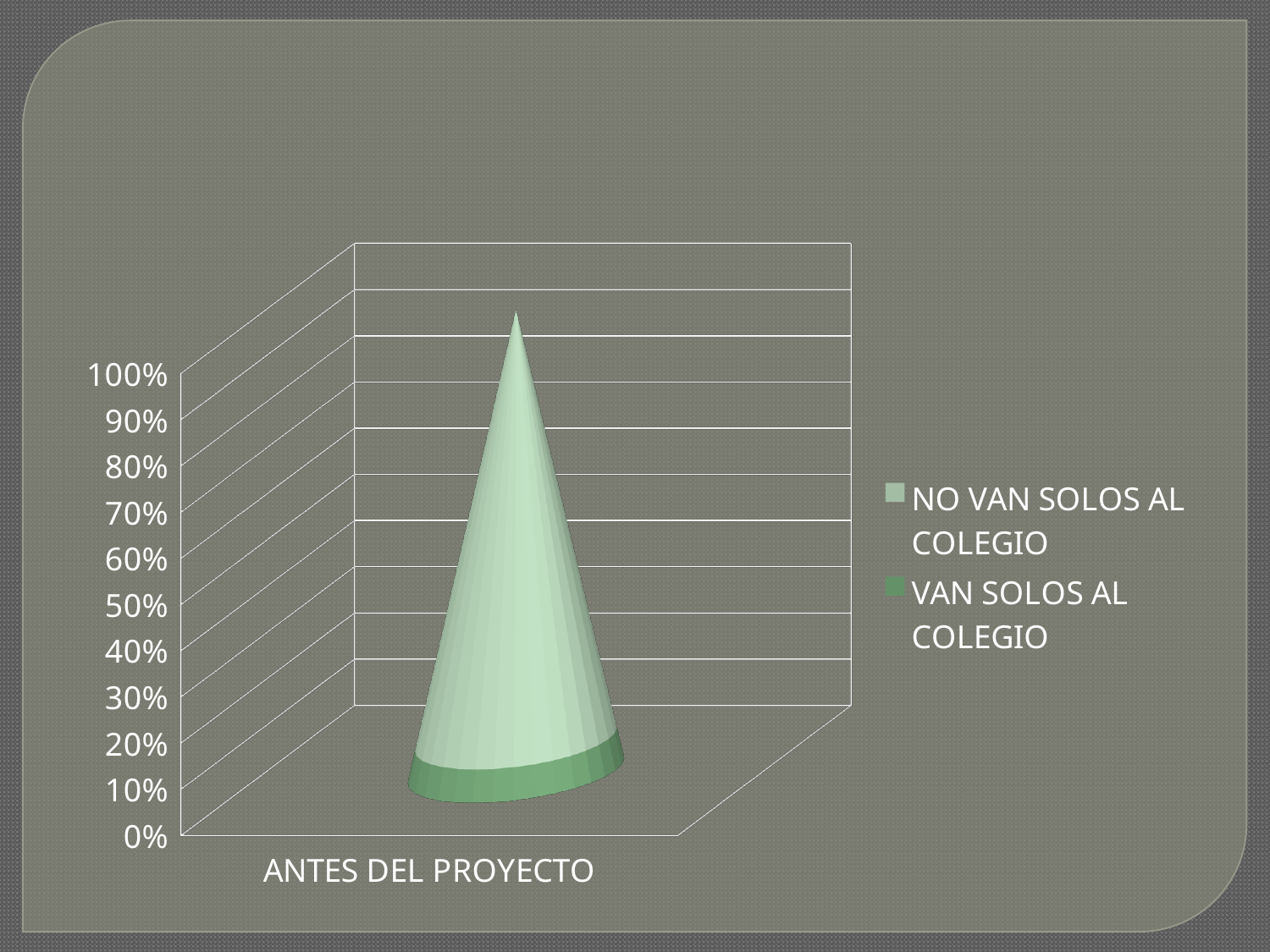
Is the value for VAN SOLOS AL COLEGIO greater or less than 20%? less Which series has the larger value for ANTES DEL PROYECTO: NO VAN SOLOS AL COLEGIO or VAN SOLOS AL COLEGIO? NO VAN SOLOS AL COLEGIO How many categories are shown on the x axis of the chart? 1 How many series does the chart's legend list? 2 What kind of chart is shown on the slide? bar chart What is the label of the single category on the x axis? ANTES DEL PROYECTO Is the value for NO VAN SOLOS AL COLEGIO greater or less than 50%? greater What is the highest value shown on the vertical axis of the chart? 100% Which series has the smaller value for ANTES DEL PROYECTO? VAN SOLOS AL COLEGIO